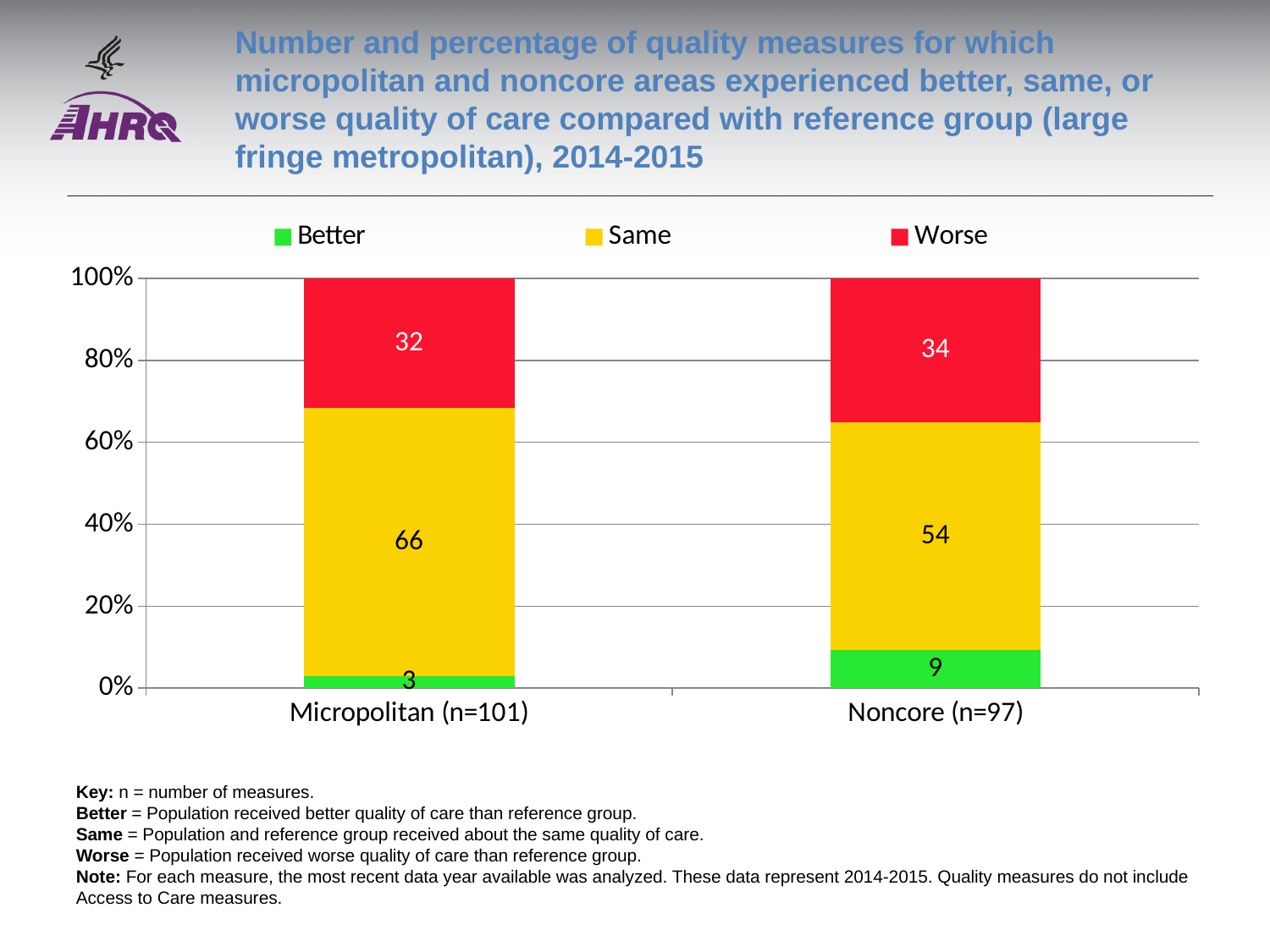
How many categories are shown on the x axis? 2 What is the number of measures labeled Better for Micropolitan (n=101)? 3 What is the difference between the Better values for Noncore (n=97) and Micropolitan (n=101)? 6 What is the number of measures labeled Same for Micropolitan (n=101)? 66 What is the number of measures labeled Better for Noncore (n=97)? 9 What kind of chart is shown on the slide? Stacked bar chart What is the number of measures labeled Worse for Noncore (n=97)? 34 What is the total of the stacked bar for Micropolitan (n=101)? 101 Which category has the higher number of Same measures, Micropolitan (n=101) or Noncore (n=97)? Micropolitan (n=101) How many series does the legend list? 3 What is the total of the stacked bar for Noncore (n=97)? 97 What is the difference between the Same values for Micropolitan (n=101) and Noncore (n=97)? 12